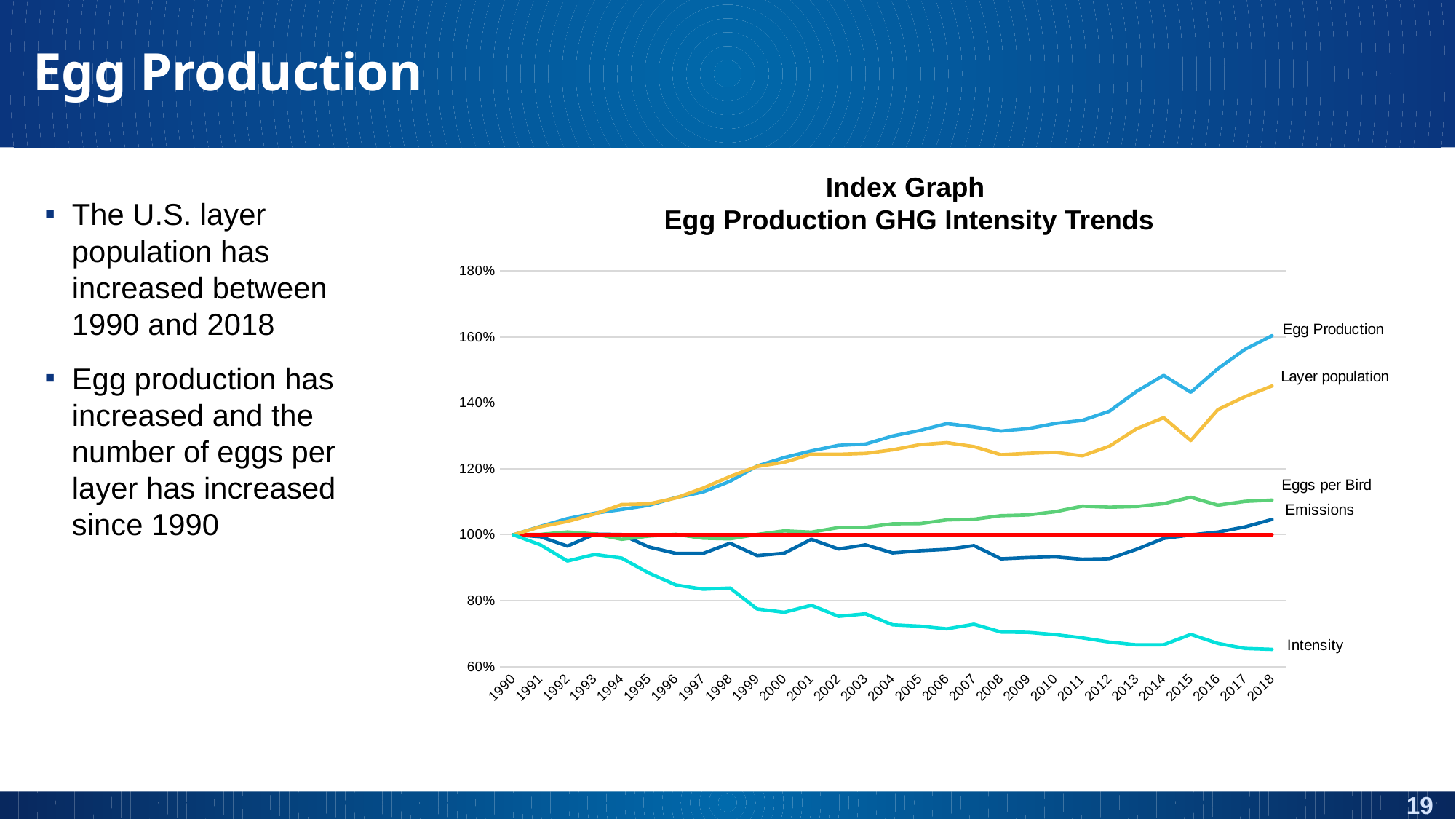
In 2018, which is larger: Egg Production or Layer population? Egg Production Which series has the highest value in 2018? Egg Production Is the value for Intensity in 2018 greater or less than 80%? less Is the value for Egg Production in 2018 greater or less than 140%? greater How many labeled data series are shown on the chart? 5 What is the value of the Egg Production series in 1990? 100% Which series has the lowest value in 2018? Intensity How many years are shown along the x axis of the chart? 29 What kind of chart is shown on the slide? Line chart Does the Intensity series rise or fall from 1990 to 2018? Fall Is the value for Emissions in 2010 greater or less than 100%? less What is the title of the chart? Index Graph Egg Production GHG Intensity Trends